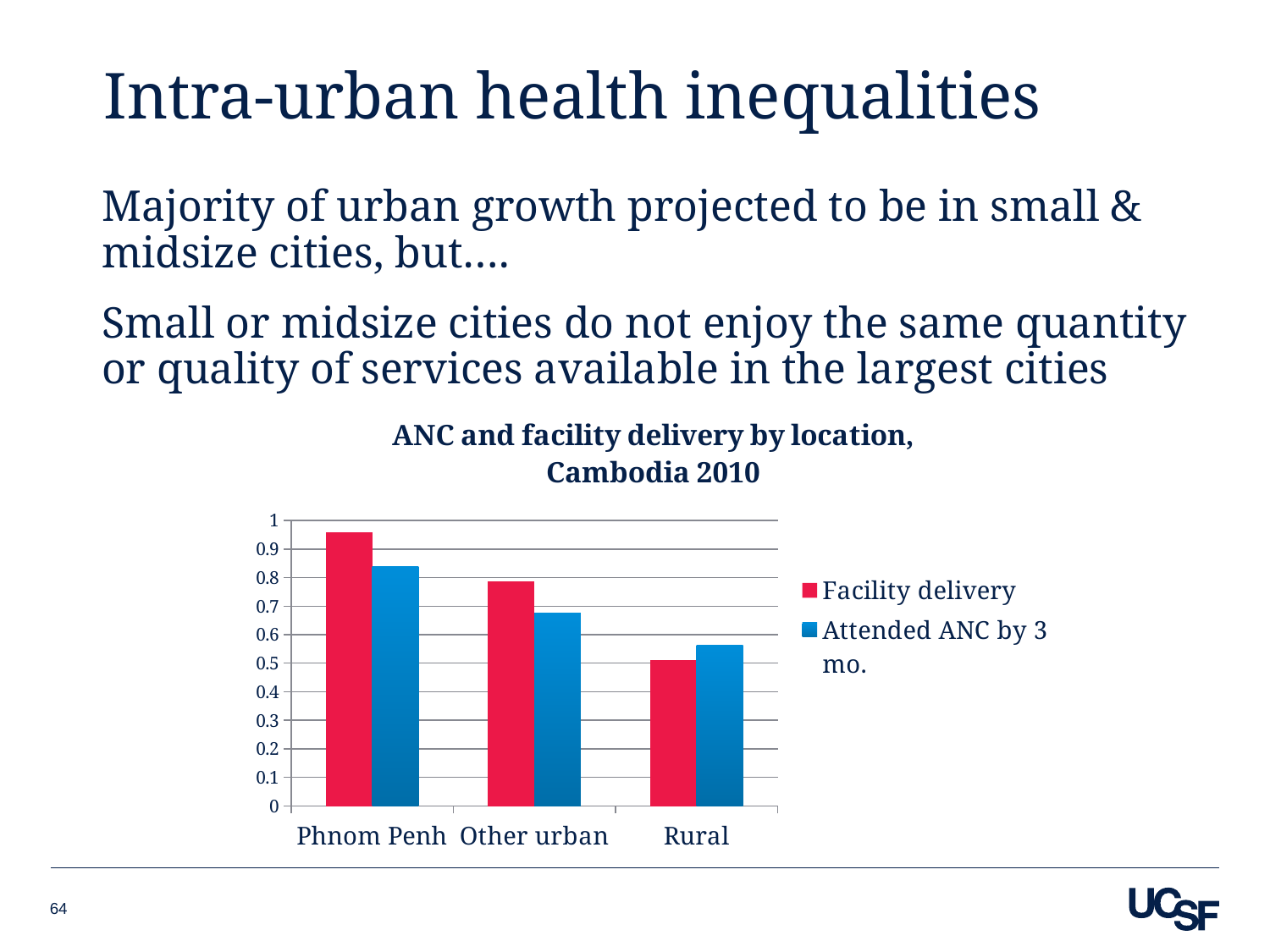
Do the Facility delivery values rise or fall moving from Phnom Penh to Rural along the x axis? Fall Is the Facility delivery value for Rural greater or less than 0.6? less Is the Facility delivery value for Other urban greater or less than 0.7? greater How many location categories are shown on the x axis of the chart? 3 For Rural, which is larger: Facility delivery or Attended ANC by 3 mo.? Attended ANC by 3 mo. How many series does the chart's legend list? 2 What is the title of the chart? ANC and facility delivery by location, Cambodia 2010 What kind of chart is shown on the slide? Bar chart Is the Facility delivery value for Phnom Penh greater or less than 0.9? greater For Phnom Penh, which is larger: Facility delivery or Attended ANC by 3 mo.? Facility delivery Which location has the highest value for Facility delivery? Phnom Penh Which location has the lowest value for Attended ANC by 3 mo.? Rural